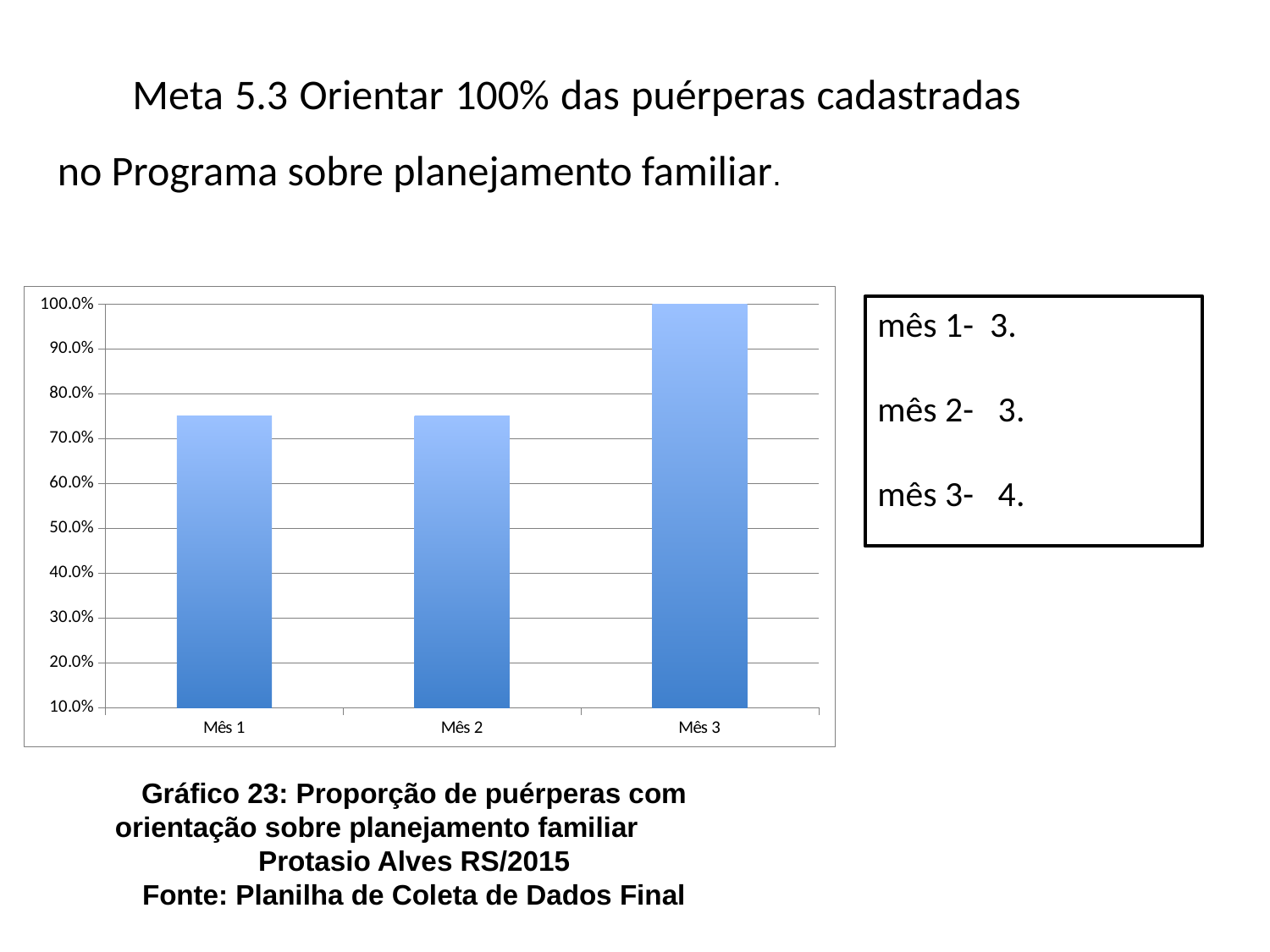
How many categories (months) are plotted on the chart? 3 What is the value for Mês 3 on the chart? 100.0% Is the value for Mês 1 greater or less than 70.0%? greater Which is larger, the value for Mês 3 or the value for Mês 1? Mês 3 What kind of chart is shown on the slide? bar chart Which month has the highest value on the chart? Mês 3 Does the value rise or fall from Mês 2 to Mês 3? rise What is the number of the graph given in the caption below the chart? Gráfico 23 Is the value for Mês 1 greater or less than 80.0%? less Is the value for Mês 2 greater or less than 80.0%? less What is the highest tick value shown on the vertical axis? 100.0%